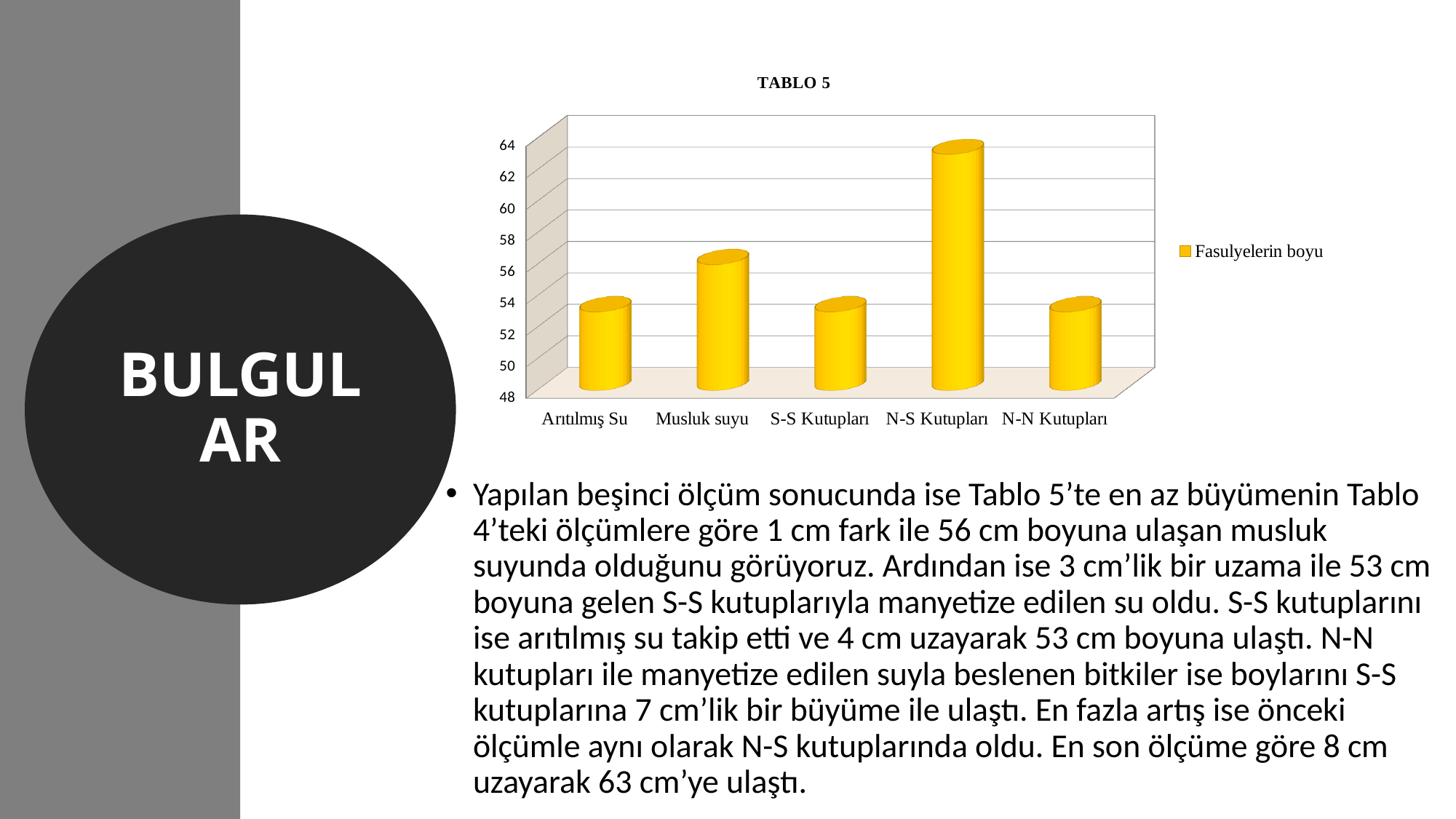
How many series does the chart's legend list? 1 Is the value for Musluk suyu greater or less than 54? greater What is the title of the chart? TABLO 5 What kind of chart is shown on the slide? bar chart Which category has the highest value in the chart? N-S Kutupları Is the value for N-N Kutupları greater or less than 58? less Which is larger, the value for Musluk suyu or the value for Arıtılmış Su? Musluk suyu Is the value for N-S Kutupları greater or less than 60? greater How many categories are shown on the x axis of the chart? 5 What is the name of the series shown in the chart's legend? Fasulyelerin boyu Which is larger, the value for N-S Kutupları or the value for S-S Kutupları? N-S Kutupları